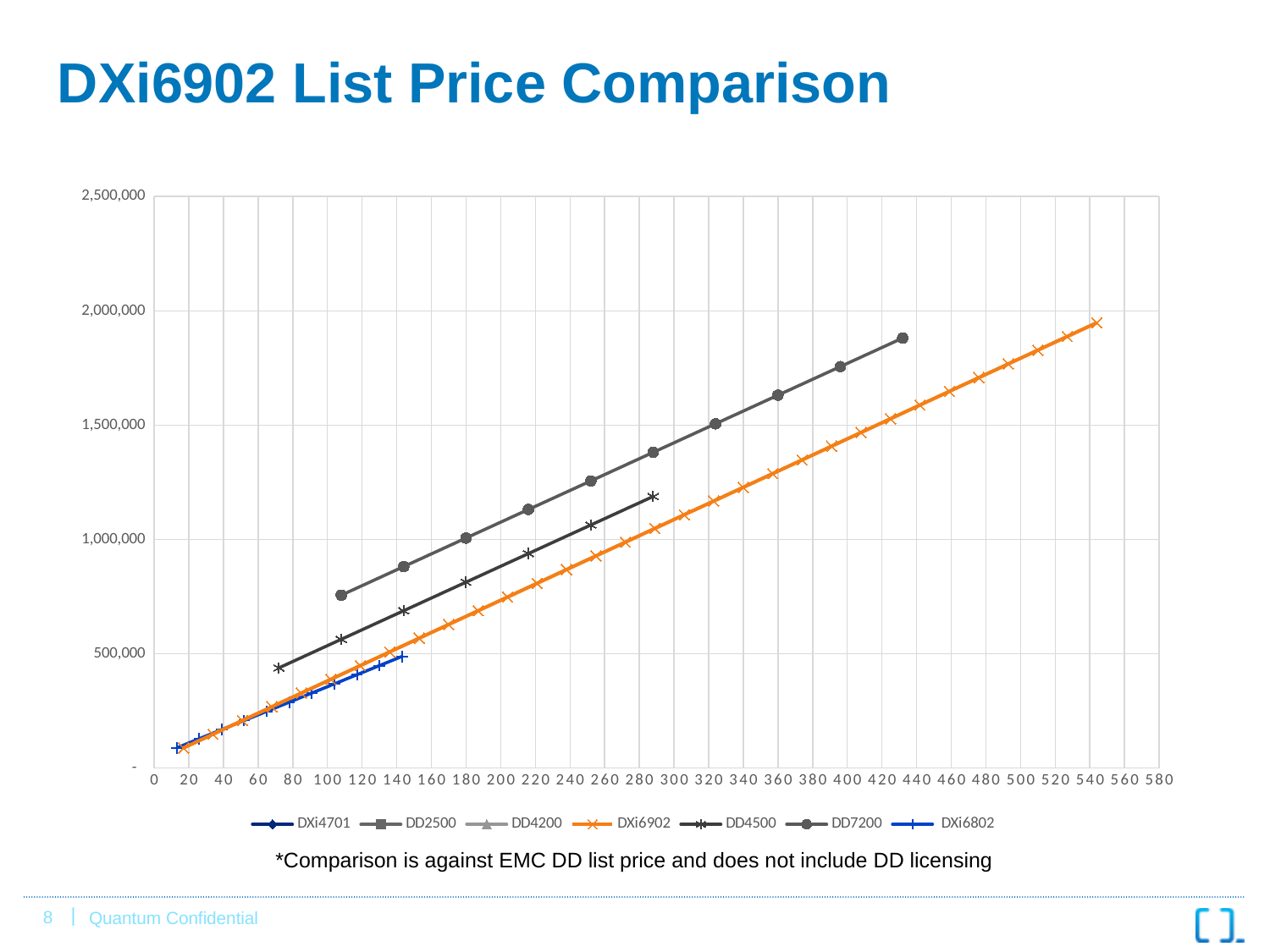
Is the highest value of the DD4500 series greater or less than 1,000,000? greater Is the highest value of the DD7200 series greater or less than 1,500,000? greater Which series is drawn in orange with x markers? DXi6902 Is the highest value of the DXi6902 series greater or less than 2,000,000? less What is the title of the slide containing the chart? DXi6902 List Price Comparison At an x value of about 250, which series has the higher value, DD7200 or DXi6902? DD7200 What kind of chart is shown on the slide? line chart How many series does the legend list? 7 Do the values for the DXi6902 series rise or fall as the x axis increases? rise At an x value of about 180, which series has the higher value, DD7200 or DD4500? DD7200 Which series extends furthest along the x axis? DXi6902